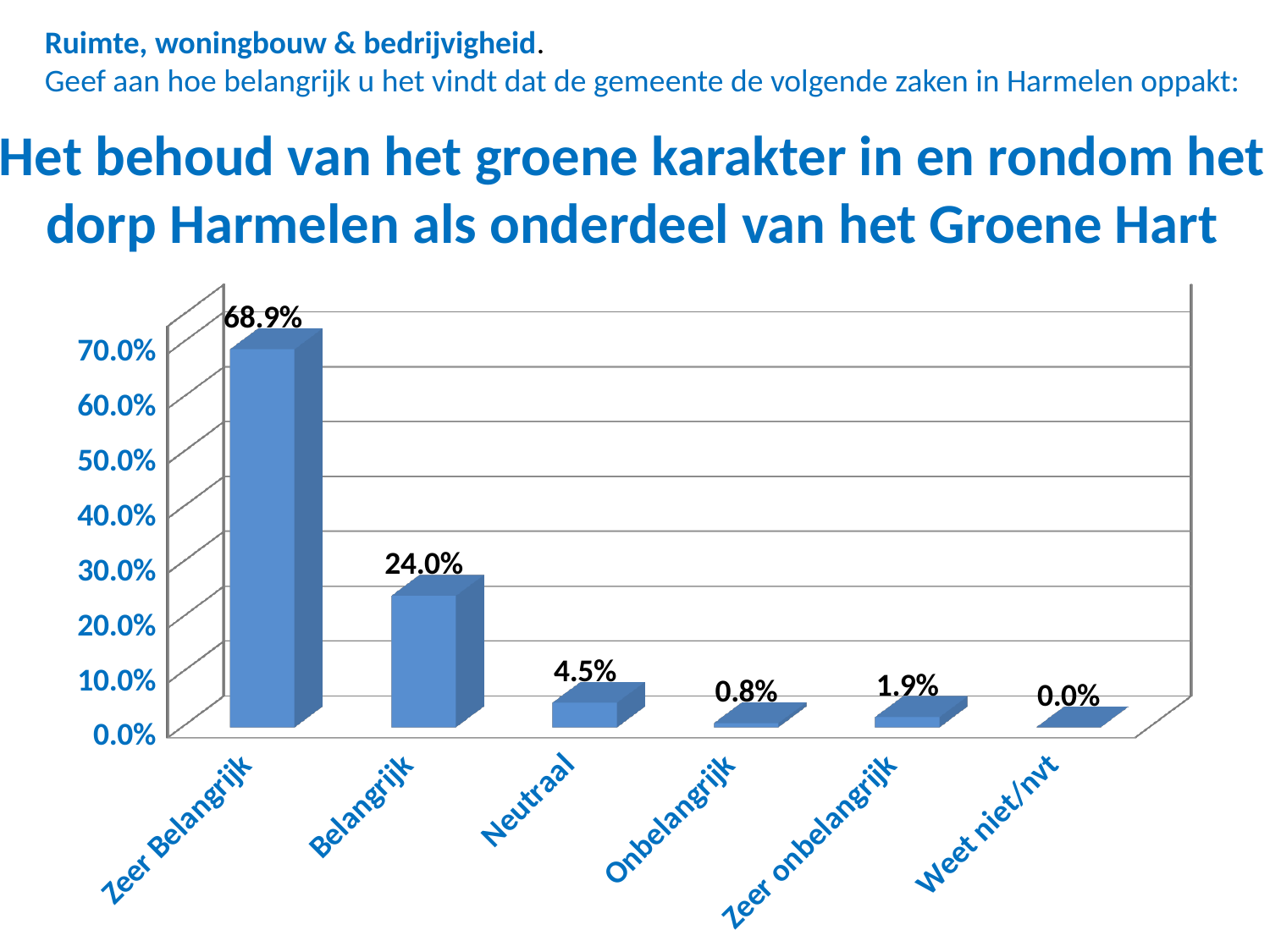
What is the value for Zeer Belangrijk? 68.9% What is the value for Zeer onbelangrijk? 1.9% What is the value for Onbelangrijk? 0.8% What is the difference between the values for Zeer Belangrijk and Belangrijk? 44.9% What is the value for Belangrijk? 24.0% What kind of chart is shown on the slide? bar chart Which category has the highest value? Zeer Belangrijk Which category has the lowest value? Weet niet/nvt What is the value for Neutraal? 4.5% Which is larger, the value for Onbelangrijk or the value for Zeer onbelangrijk? Zeer onbelangrijk Is the value for Belangrijk greater or less than 30.0%? less How many categories are shown on the x axis? 6